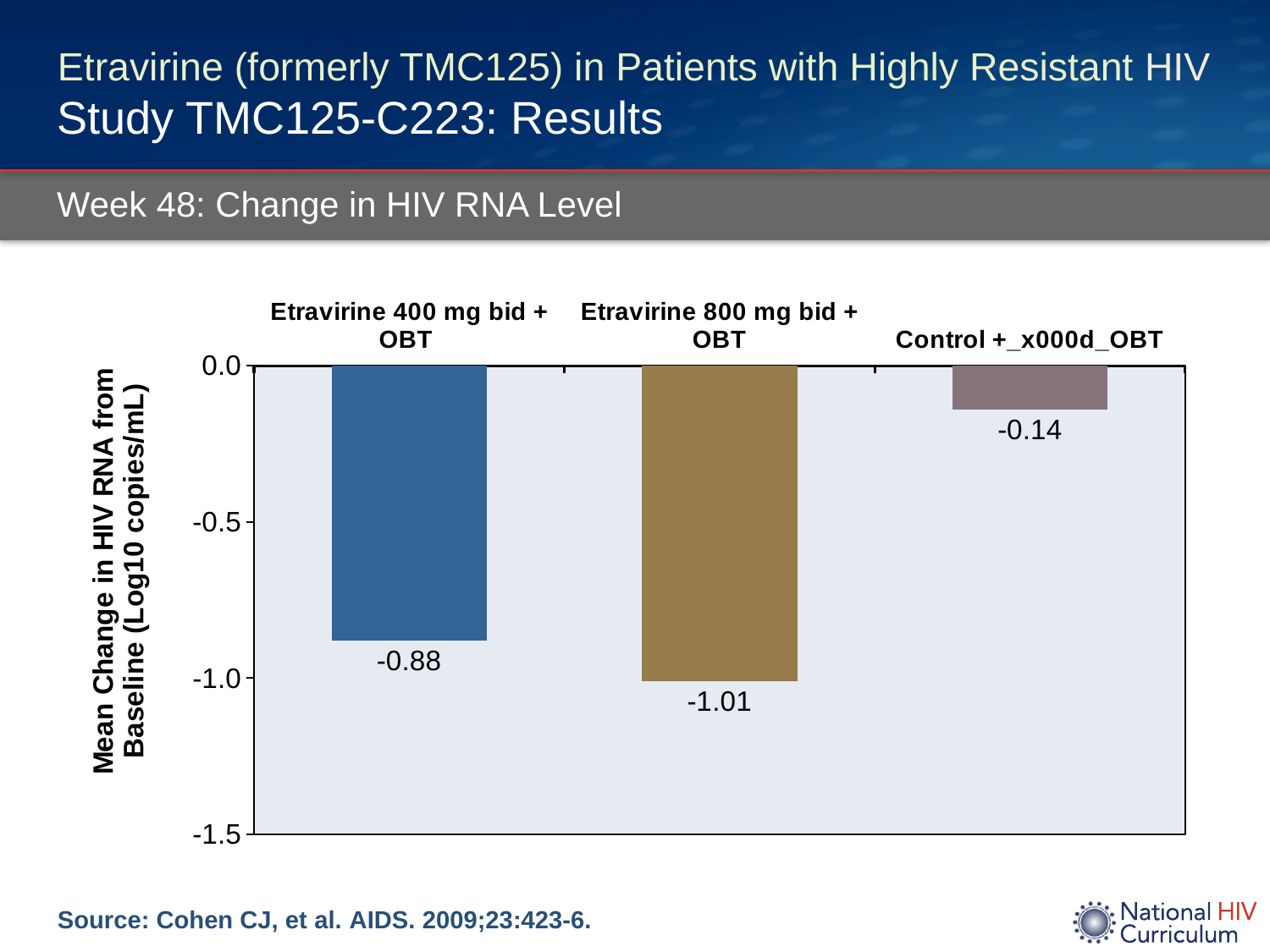
Which group had a greater decrease in HIV RNA: Etravirine 400 mg bid + OBT or Control + OBT? Etravirine 400 mg bid + OBT Which group shows the largest decrease in HIV RNA from baseline? Etravirine 800 mg bid + OBT Is the value for Etravirine 400 mg bid + OBT greater or less than -0.5? less What is the mean change in HIV RNA for the Control + OBT group? -0.14 What is the mean change in HIV RNA for Etravirine 800 mg bid + OBT? -1.01 What is the label of the vertical axis? Mean Change in HIV RNA from Baseline (Log10 copies/mL) How many treatment groups are shown in the chart? 3 What is the difference between the mean change for Etravirine 400 mg bid + OBT and Control + OBT? 0.74 Which group shows the smallest change in HIV RNA from baseline? Control + OBT What type of chart is shown on the slide? Bar chart What is the mean change in HIV RNA for Etravirine 400 mg bid + OBT? -0.88 What is the difference between the mean change for Etravirine 800 mg bid + OBT and Etravirine 400 mg bid + OBT? 0.13